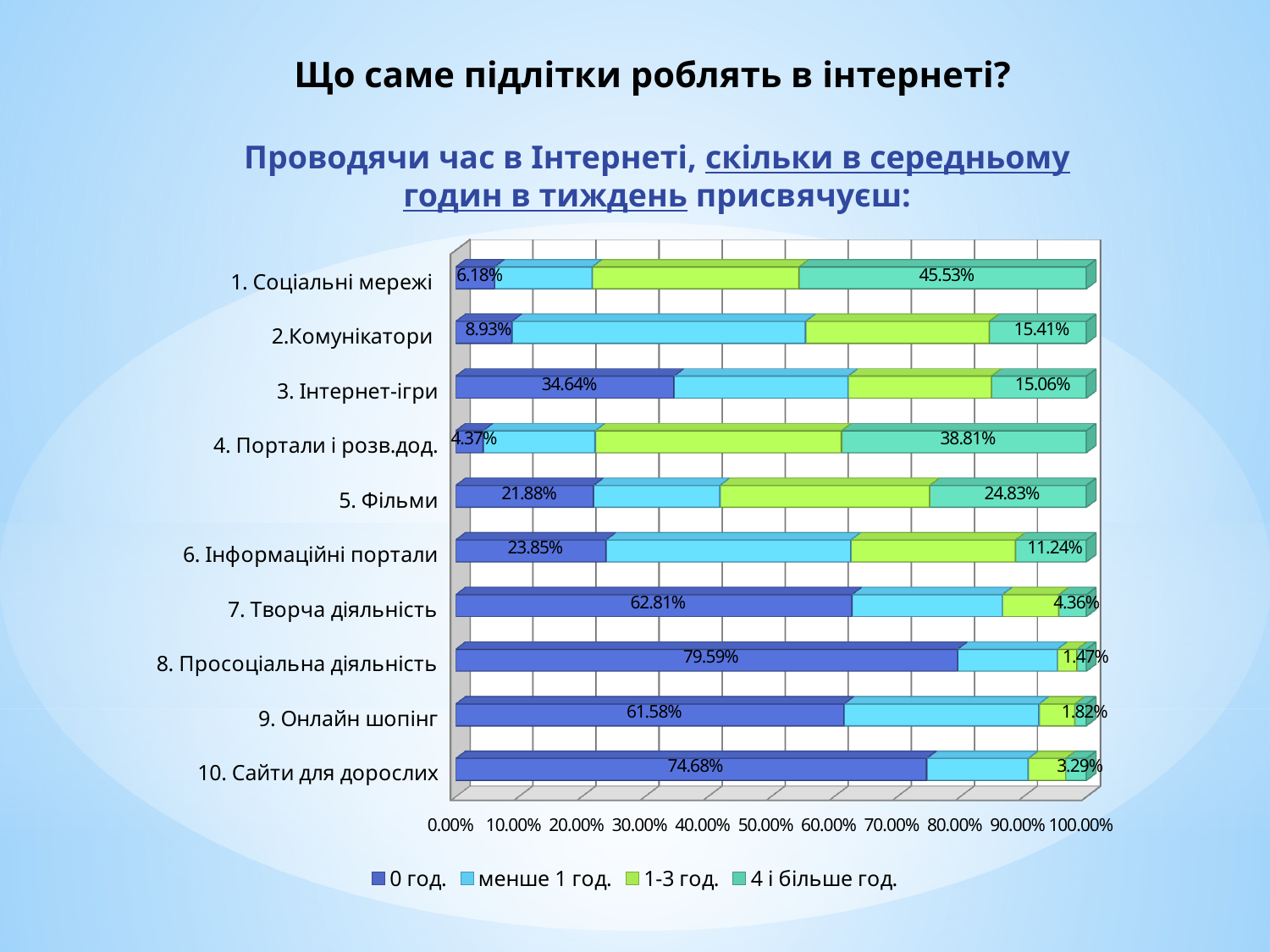
Which category has the highest 4 і більше год. value? 1. Соціальні мережі What is the difference between the 0 год. values for 7. Творча діяльність and 9. Онлайн шопінг? 1.23% What is the value of the 4 і більше год. series for 4. Портали і розв.дод.? 38.81% What percentage of respondents spend 0 год. on 1. Соціальні мережі? 6.18% What is the 0 год. value for 3. Інтернет-ігри? 34.64% What type of chart is shown on the slide? Stacked bar chart Which category has the highest 0 год. value? 8. Просоціальна діяльність Which category has the lowest 0 год. value? 4. Портали і розв.дод. How many series does the legend list? 4 How many categories are shown on the chart? 10 What is the 4 і більше год. value for 9. Онлайн шопінг? 1.82% Which is larger: the 4 і більше год. value for 5. Фільми or for 2.Комунікатори? 5. Фільми